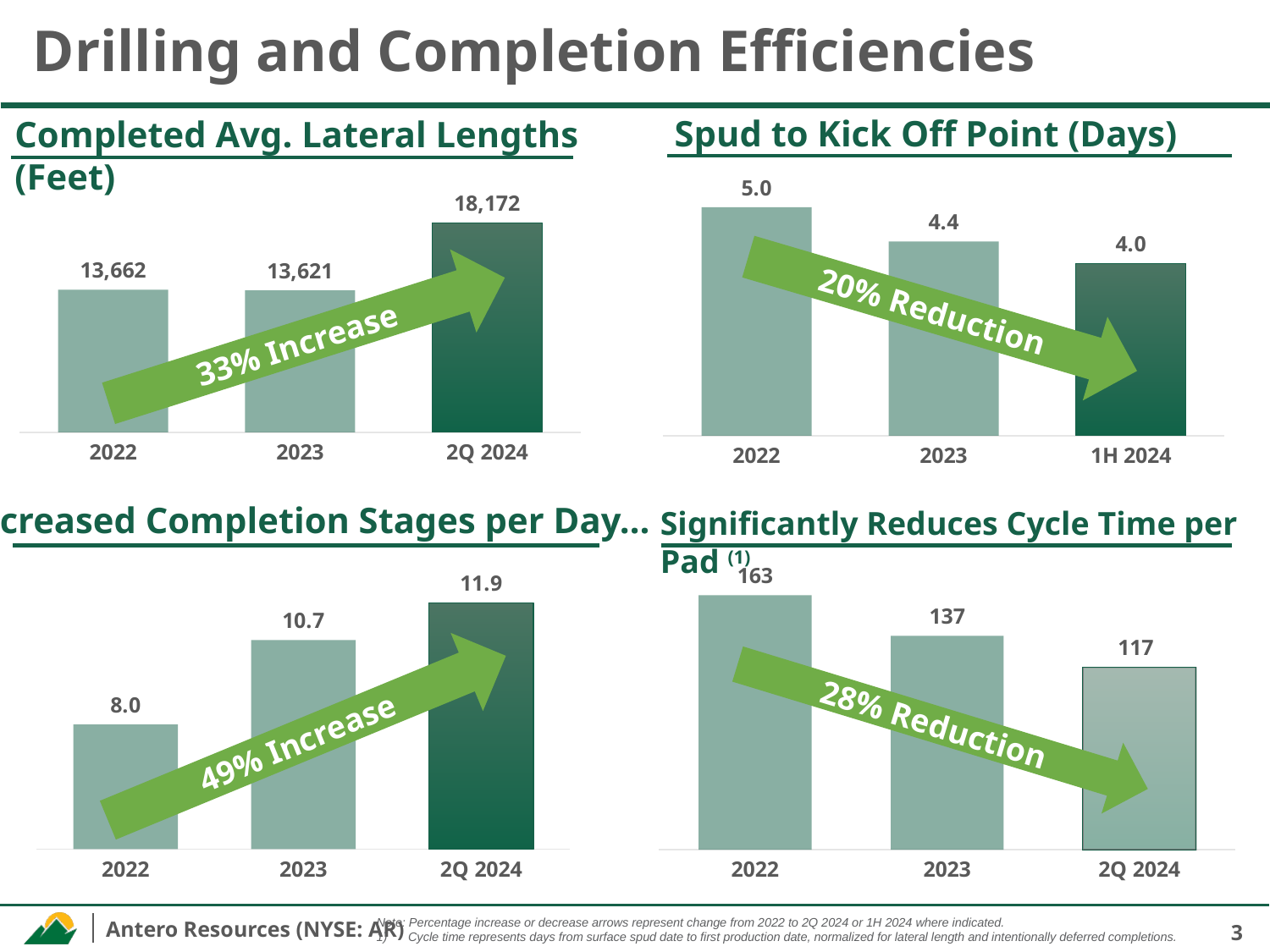
What type of chart is the Spud to Kick Off Point (Days) chart? bar chart In the Significantly Reduces Cycle Time per Pad chart, which is larger, the value for 2022 or the value for 2Q 2024? 2022 In the Spud to Kick Off Point (Days) chart, what is the value for 2023? 4.4 In the Completed Avg. Lateral Lengths (Feet) chart, which category has the lowest value? 2023 How many categories are shown in the Significantly Reduces Cycle Time per Pad chart? 3 In the Completed Avg. Lateral Lengths (Feet) chart, what is the difference between the 2Q 2024 value and the 2022 value? 4,510 In the bottom-left chart (Completion Stages per Day), what is the value for 2022? 8.0 In the Spud to Kick Off Point (Days) chart, do the values rise or fall from 2022 to 1H 2024? fall In the Significantly Reduces Cycle Time per Pad chart, what is the value for 2023? 137 In the bottom-left chart (Completion Stages per Day), which category has the highest value? 2Q 2024 In the Spud to Kick Off Point (Days) chart, what is the difference between the 2022 value and the 1H 2024 value? 1.0 In the Completed Avg. Lateral Lengths (Feet) chart, what is the value for 2Q 2024? 18,172